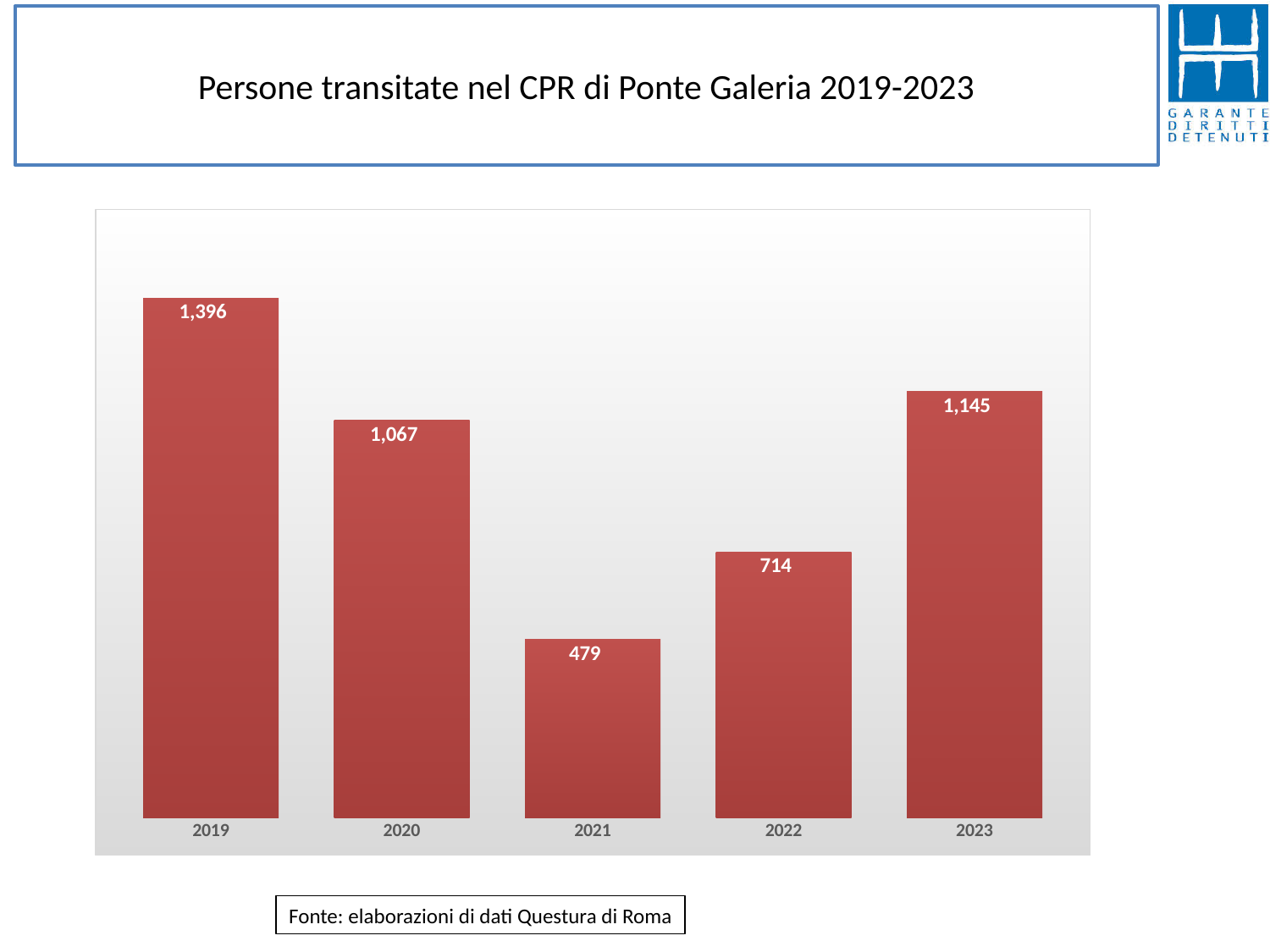
Do the values rise or fall from 2021 to 2023? rise How many years are shown on the x axis? 5 What is the value for 2023? 1,145 Which year has the lowest value? 2021 What is the value for 2021? 479 What kind of chart is shown on the slide? bar chart What is the difference between the values for 2023 and 2022? 431 What is the difference between the values for 2019 and 2020? 329 What is the title of the slide? Persone transitate nel CPR di Ponte Galeria 2019-2023 Which is larger, the value for 2020 or the value for 2023? 2023 What is the value for 2019? 1,396 Which year has the highest value? 2019